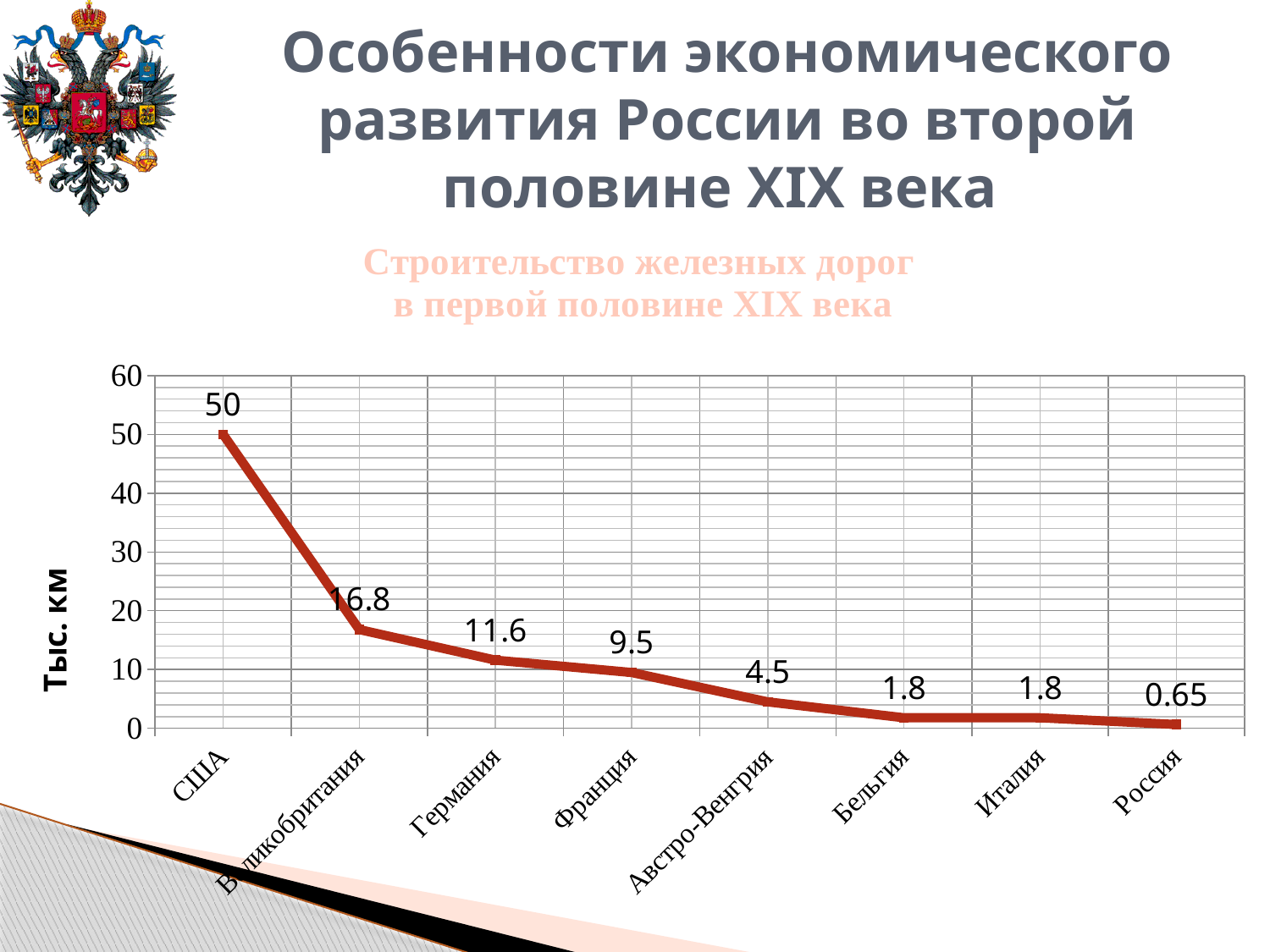
Which is larger, the value for Германия or the value for Франция? Германия Which country has the highest value on the chart? США How many countries are plotted on the chart? 8 What value is shown for Россия (Russia) on the chart? 0.65 Which country has the lowest value on the chart? Россия What is the difference between the values for США and Великобритания? 33.2 What value is shown for Австро-Венгрия (Austria-Hungary) on the chart? 4.5 What value is shown for Германия (Germany) on the chart? 11.6 What is the difference between the values for Франция and Австро-Венгрия? 5 What kind of chart is shown on the slide? Line chart What value is shown for США (USA) on the chart? 50 What is the label on the vertical axis of the chart? Тыс. км